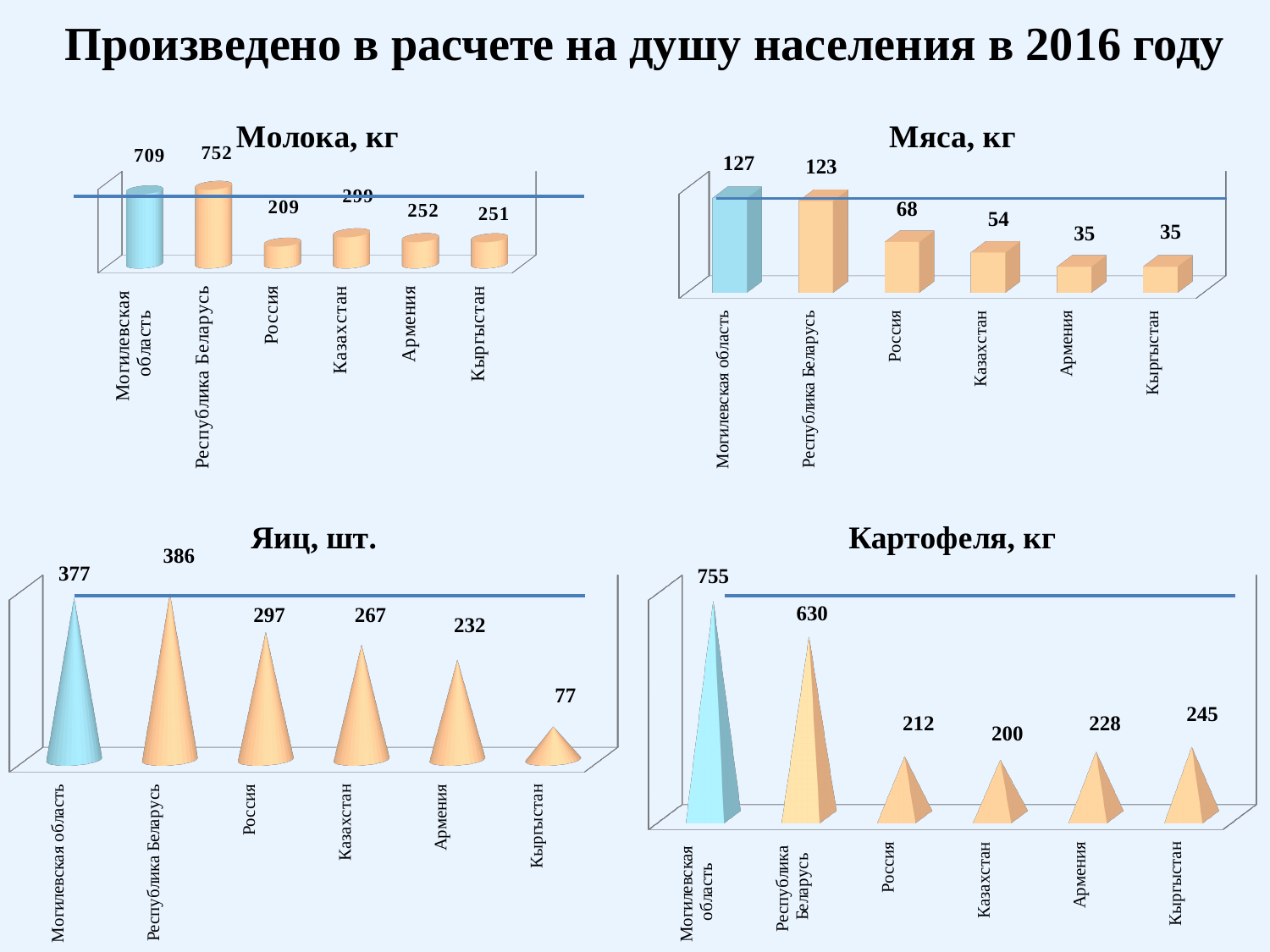
In the chart titled "Мяса, кг", what is the difference between the values for Могилевская область and Республика Беларусь? 4 In the chart titled "Картофеля, кг", what is the value for Могилевская область? 755 How many charts are on the slide? 4 How many categories are shown in the chart titled "Мяса, кг"? 6 In the chart titled "Картофеля, кг", what is the difference between the values for Могилевская область and Республика Беларусь? 125 In the chart titled "Молока, кг", which is larger, the value for Армения or the value for Россия? Армения In the chart titled "Яиц, шт.", what is the value for Кыргызстан? 77 In the chart titled "Яиц, шт.", which category has the highest value? Республика Беларусь In the chart titled "Молока, кг", what is the value for Республика Беларусь? 752 What kind of chart is the chart titled "Молока, кг"? bar chart In the chart titled "Картофеля, кг", which category has the lowest value? Казахстан In the chart titled "Мяса, кг", what is the value for Россия? 68